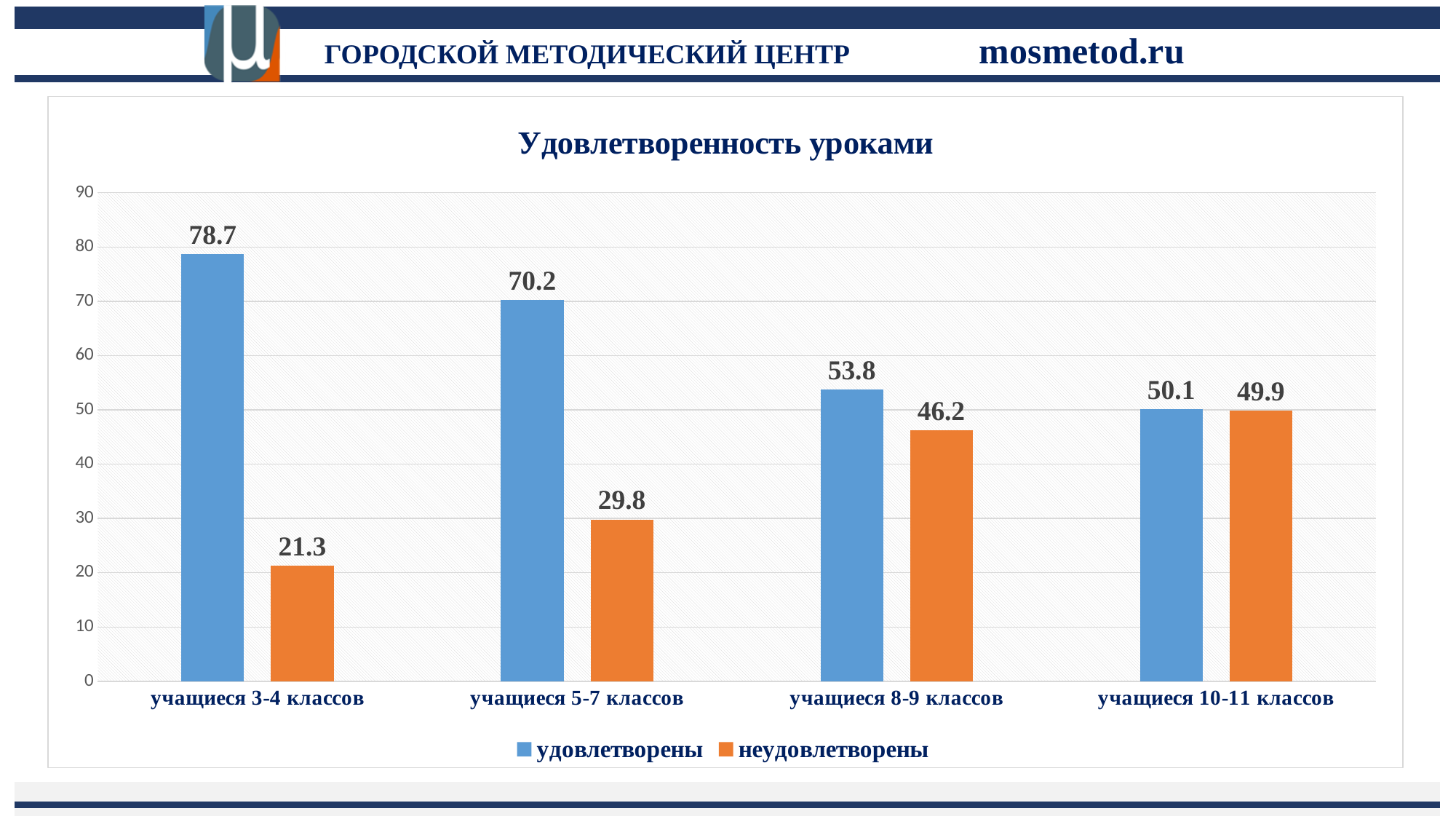
How many series does the legend list? 2 Which is larger for учащиеся 8-9 классов: 'удовлетворены' or 'неудовлетворены'? удовлетворены What is the value for 'удовлетворены' among учащиеся 3-4 классов? 78.7 How many categories are shown on the x axis? 4 What is the value for 'неудовлетворены' among учащиеся 5-7 классов? 29.8 What kind of chart is shown on the slide? bar chart What is the value for 'удовлетворены' among учащиеся 8-9 классов? 53.8 Which category has the highest value for 'удовлетворены'? учащиеся 3-4 классов Do the values for 'удовлетворены' rise or fall from left to right along the x axis? fall What is the value for 'неудовлетворены' among учащиеся 10-11 классов? 49.9 What is the difference between 'удовлетворены' and 'неудовлетворены' for учащиеся 3-4 классов? 57.4 Which category has the lowest value for 'неудовлетворены'? учащиеся 3-4 классов